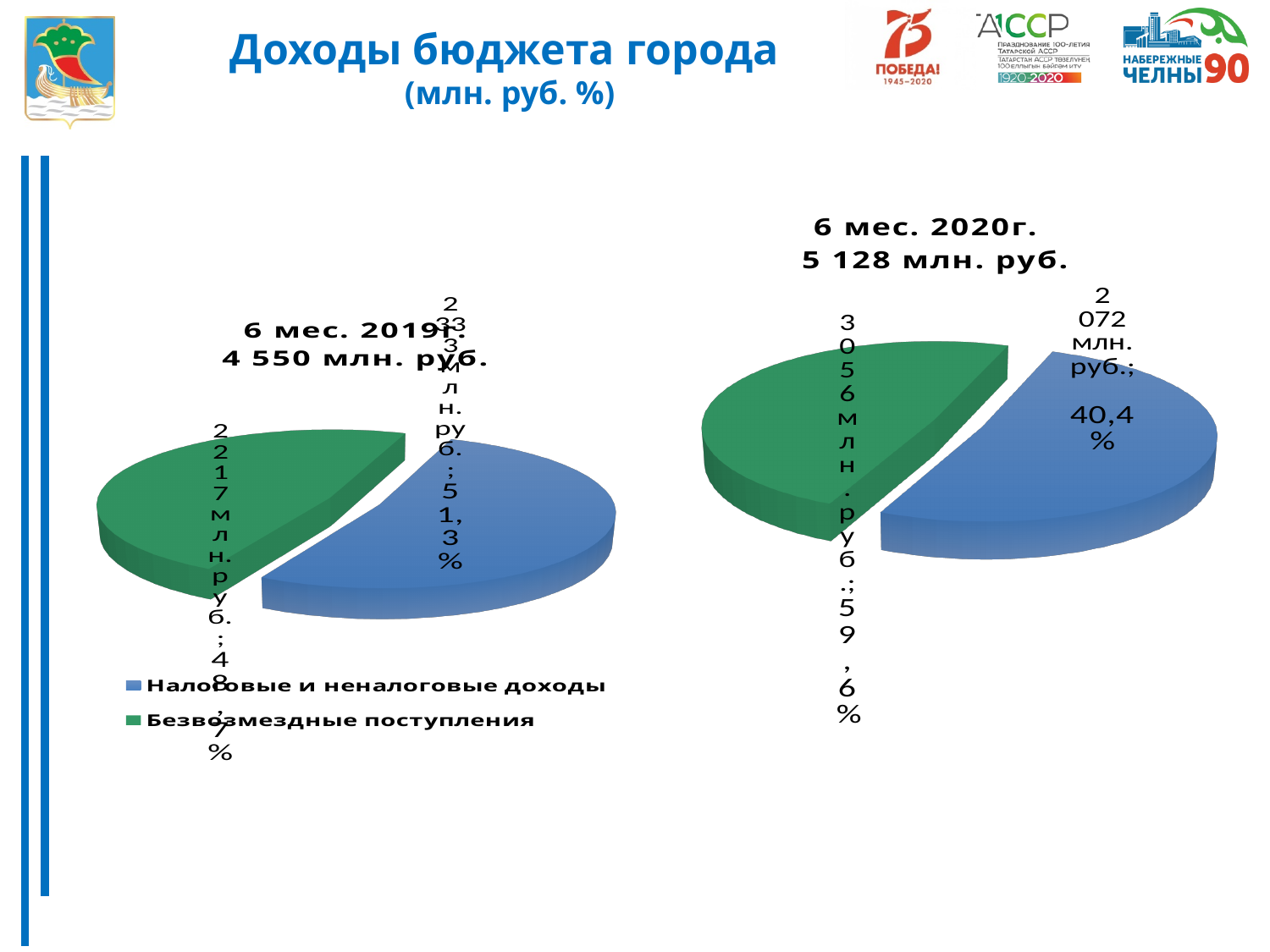
How many entries does the legend list for the pie charts? 2 What colour represents Безвозмездные поступления in the pie charts? Green In the '6 мес. 2020г.' pie chart, what share does Налоговые и неналоговые доходы have? 40,4% What is the total shown for the '6 мес. 2019г.' pie chart? 4 550 млн. руб. In the '6 мес. 2020г.' pie chart, what is the difference between Безвозмездные поступления and Налоговые и неналоговые доходы? 984 млн. руб. What kind of chart is used on this slide to show the city budget revenues? Pie chart In the '6 мес. 2020г.' pie chart, what share does Безвозмездные поступления have? 59,6% In the '6 мес. 2020г.' pie chart, what is the value for Налоговые и неналоговые доходы? 2 072 млн. руб. In the '6 мес. 2020г.' pie chart, which category is the largest? Безвозмездные поступления In the '6 мес. 2019г.' pie chart, what share does Налоговые и неналоговые доходы have? 51,3% What is the total shown for the '6 мес. 2020г.' pie chart? 5 128 млн. руб. In the '6 мес. 2020г.' pie chart, what is the value for Безвозмездные поступления? 3 056 млн. руб.